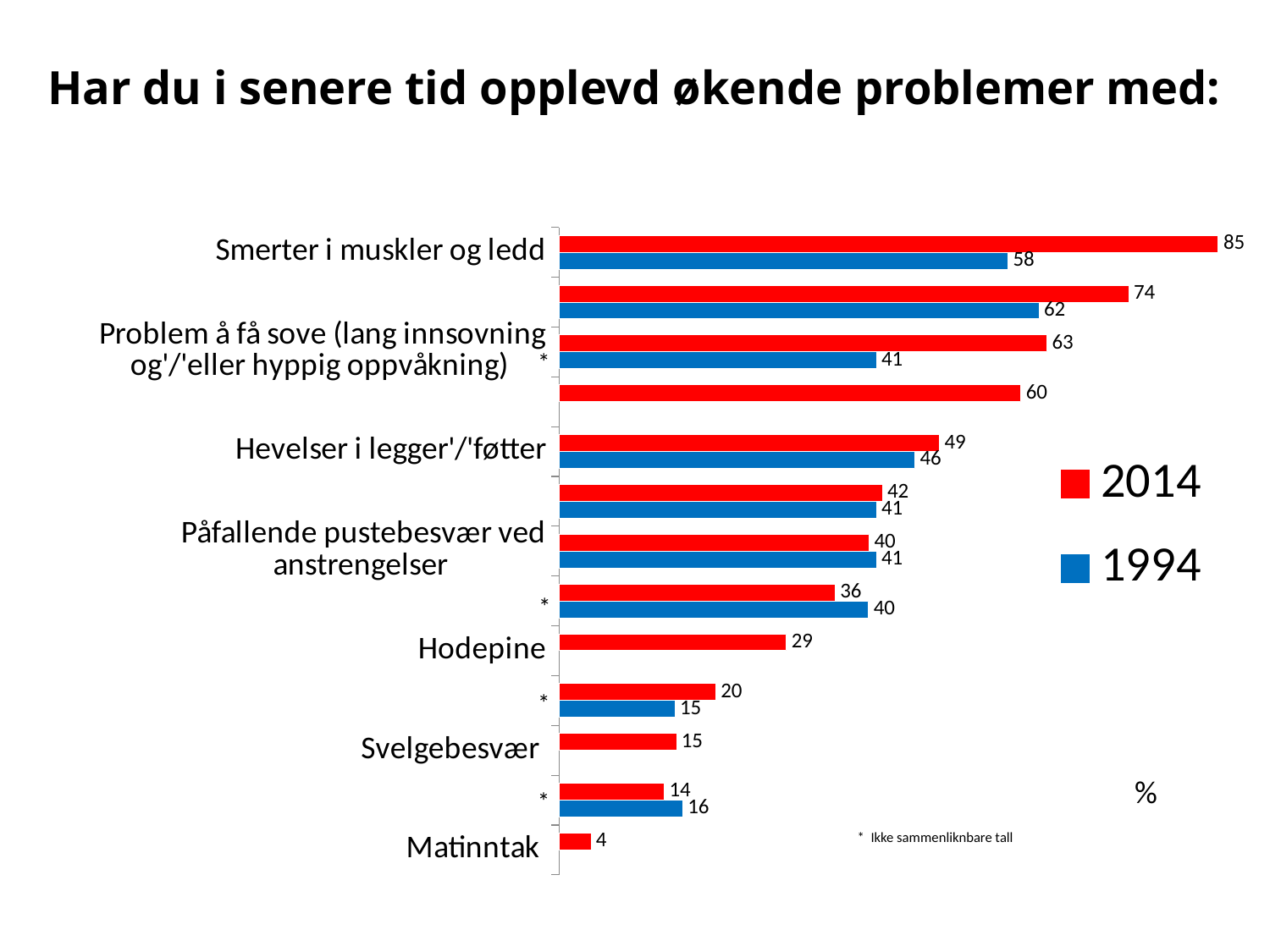
What is the 2014 value for "Hodepine"? 29 What is the 2014 value for "Matinntak"? 4 For "Påfallende pustebesvær ved anstrengelser", which year has the larger value, 2014 or 1994? 1994 What is the 2014 value for "Smerter i muskler og ledd"? 85 What is the 2014 value for "Hevelser i legger'/'føtter"? 49 What is the 1994 value for "Smerter i muskler og ledd"? 58 What is the 1994 value for "Påfallende pustebesvær ved anstrengelser"? 41 How many series does the legend list? 2 Which category has the lowest 2014 value? Matinntak What is the difference between the 2014 and 1994 values for "Smerter i muskler og ledd"? 27 Which category has the highest 2014 value? Smerter i muskler og ledd What kind of chart is shown on the slide? Bar chart